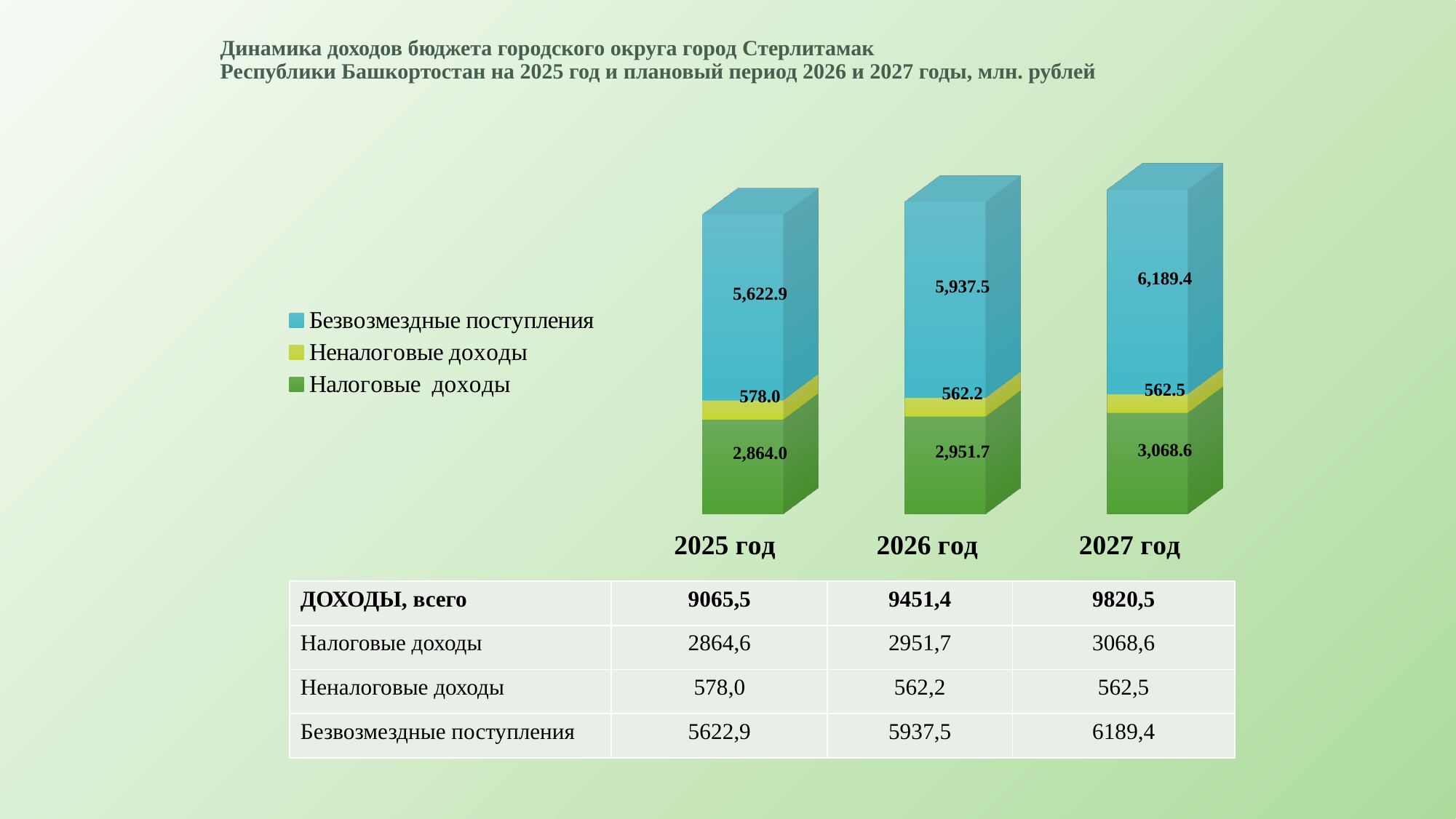
What kind of chart is shown on the slide? Stacked bar chart What is the total of the stacked bar for 2026 год? 9,451.4 In which year is the value of Безвозмездные поступления the highest? 2027 год What is the value of Неналоговые доходы for 2026 год? 562.2 How many years are shown on the x axis of the chart? 3 By how much does Безвозмездные поступления in 2027 год exceed the value in 2026 год? 251.9 Do the values of Безвозмездные поступления rise or fall from 2025 год to 2027 год? Rise How many series does the legend list? 3 Which year has the larger value of Неналоговые доходы, 2025 год or 2027 год? 2025 год In which year is the value of Налоговые доходы the lowest? 2025 год What is the value of Налоговые доходы for 2027 год? 3,068.6 What is the value of Безвозмездные поступления for 2025 год? 5,622.9